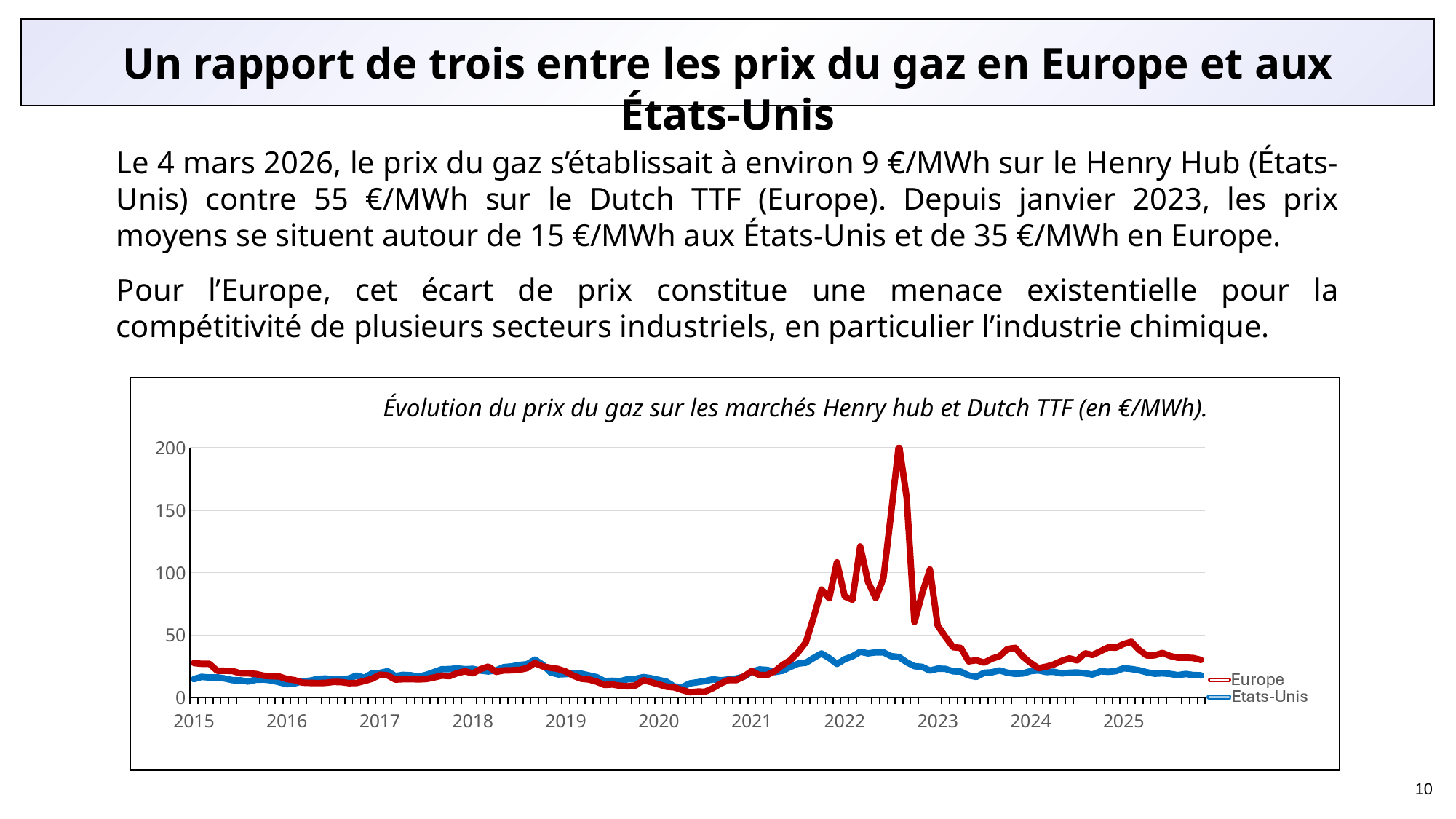
Does the Europe series rise or fall between its 2022 peak and the end of 2023? fall Is the highest value of the Etats-Unis series greater or less than 50? less In which year does the Europe series reach its highest value? 2022 Is the value of the Europe series at the end of 2025 greater or less than 50? less Which two series are listed in the chart's legend? Europe and Etats-Unis In 2022, which series has the higher values, Europe or Etats-Unis? Europe How many year labels are shown on the x axis? 11 What is the highest tick value shown on the y axis? 200 What kind of chart is shown on the slide? line chart What is the title of the chart? Évolution du prix du gaz sur les marchés Henry hub et Dutch TTF (en €/MWh). Is the peak value of the Europe series in 2022 greater or less than 150? greater How many series does the chart's legend list? 2